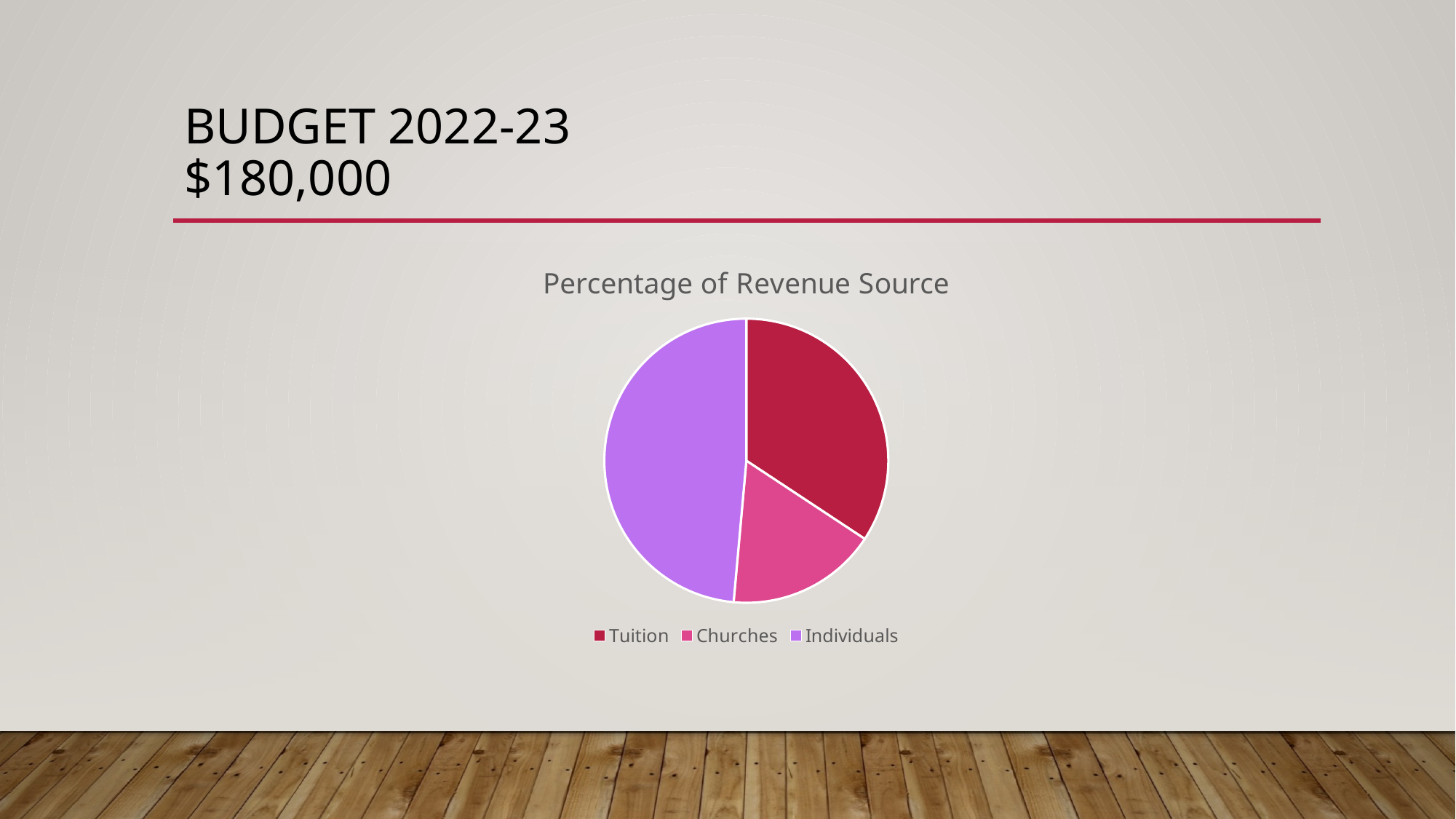
How many entries does the chart legend list? 3 Which revenue source has the largest slice of the pie? Individuals What kind of chart is shown on the slide? pie chart Which revenue source has the smallest slice of the pie? Churches What is the title of the chart? Percentage of Revenue Source What are the three revenue sources listed in the legend? Tuition, Churches, Individuals Which slice is larger, Individuals or Churches? Individuals Which slice is larger, Individuals or Tuition? Individuals What colour is the Individuals slice in the pie chart? purple How many slices does the pie chart have? 3 Which slice is larger, Tuition or Churches? Tuition